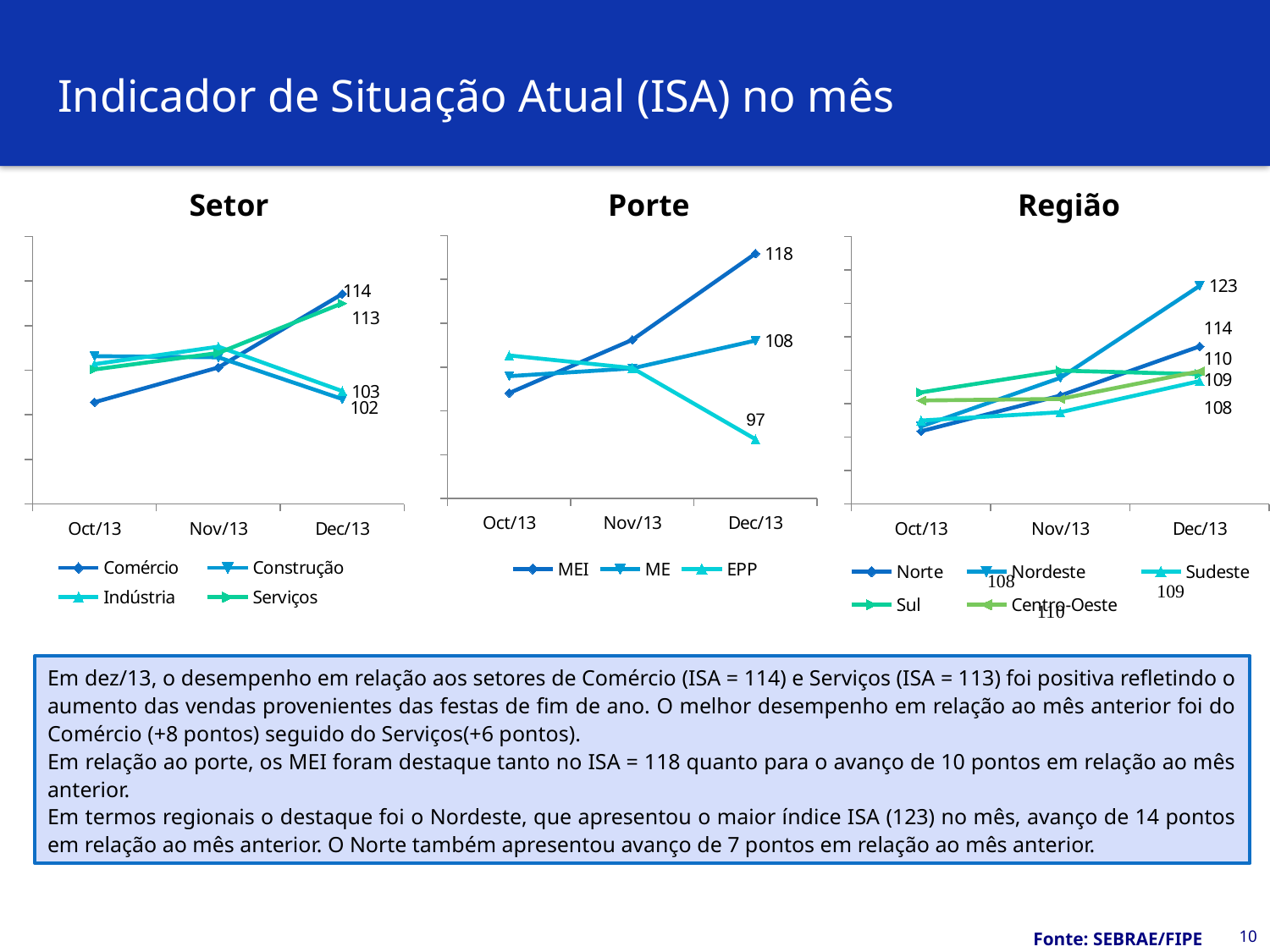
How many series does the legend of the Setor chart list? 4 In the Setor chart, what is the value for Serviços in Dec/13? 113 In the Porte chart, what is the value for EPP in Dec/13? 97 In the Região chart, what is the value for Nordeste in Dec/13? 123 In the Porte chart, what is the difference between the MEI and EPP values in Dec/13? 21 In the Porte chart, which series has the lowest value in Dec/13? EPP In the Setor chart, what is the value for Comércio in Dec/13? 114 In the Porte chart, what is the value for ME in Dec/13? 108 In the Região chart, which series has the highest value in Dec/13? Nordeste In the Porte chart, does the MEI series rise or fall from Oct/13 to Dec/13? rises In the Porte chart, what is the value for MEI in Dec/13? 118 In the Porte chart, which series has the highest value in Dec/13? MEI